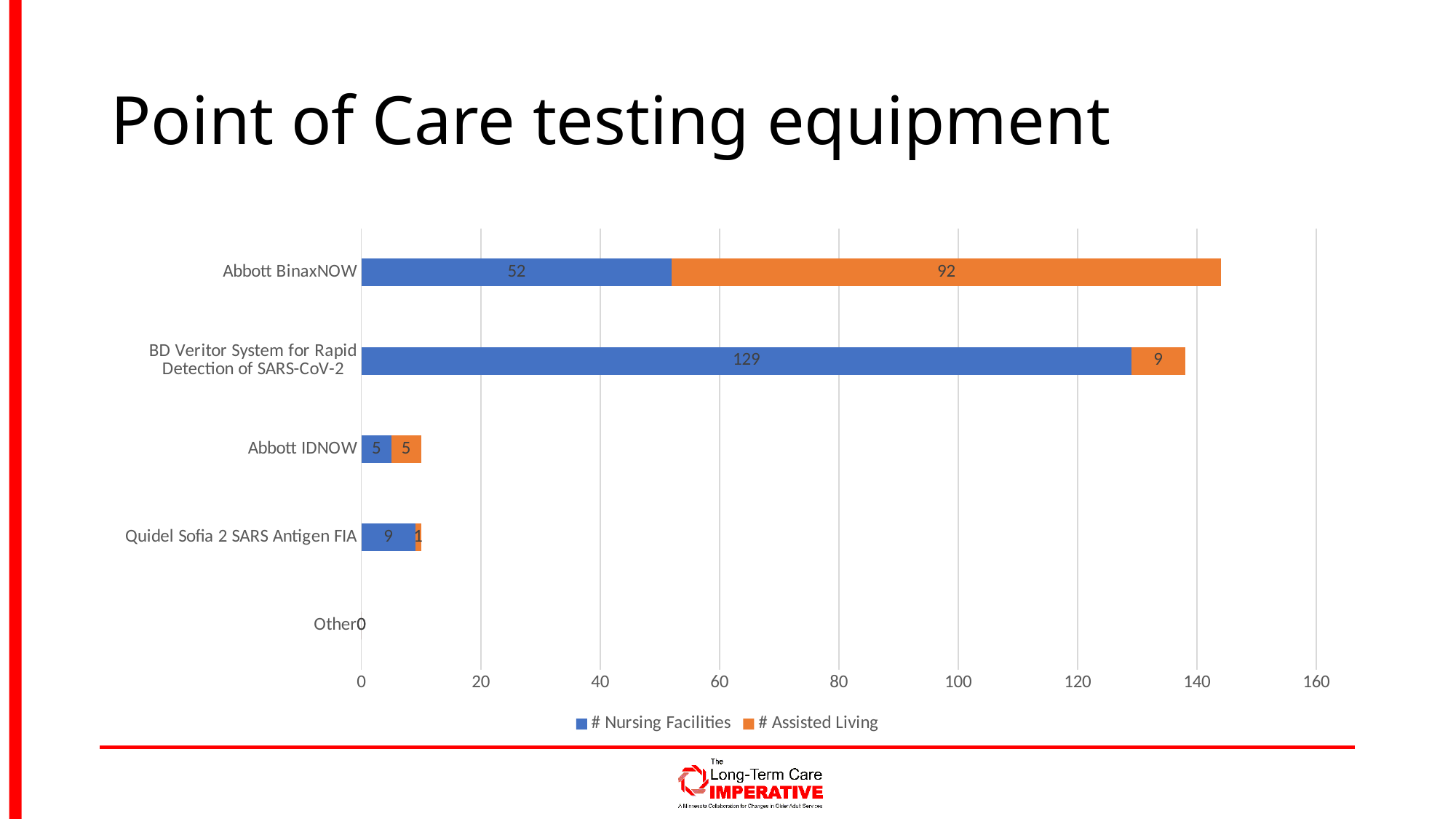
What is the difference between the # Nursing Facilities and # Assisted Living values for BD Veritor System for Rapid Detection of SARS-CoV-2? 120 What kind of chart is shown on the slide? Stacked bar chart What is the # Nursing Facilities value for BD Veritor System for Rapid Detection of SARS-CoV-2? 129 What is the total of the stacked bar for Abbott BinaxNOW? 144 Which category has the highest # Nursing Facilities value? BD Veritor System for Rapid Detection of SARS-CoV-2 What is the # Nursing Facilities value for Abbott BinaxNOW? 52 Which category has the highest # Assisted Living value? Abbott BinaxNOW How many categories are shown on the chart? 5 What is the # Assisted Living value for Abbott BinaxNOW? 92 What is the # Assisted Living value for Quidel Sofia 2 SARS Antigen FIA? 1 Which is larger for Abbott BinaxNOW: # Nursing Facilities or # Assisted Living? # Assisted Living How many series does the legend list? 2